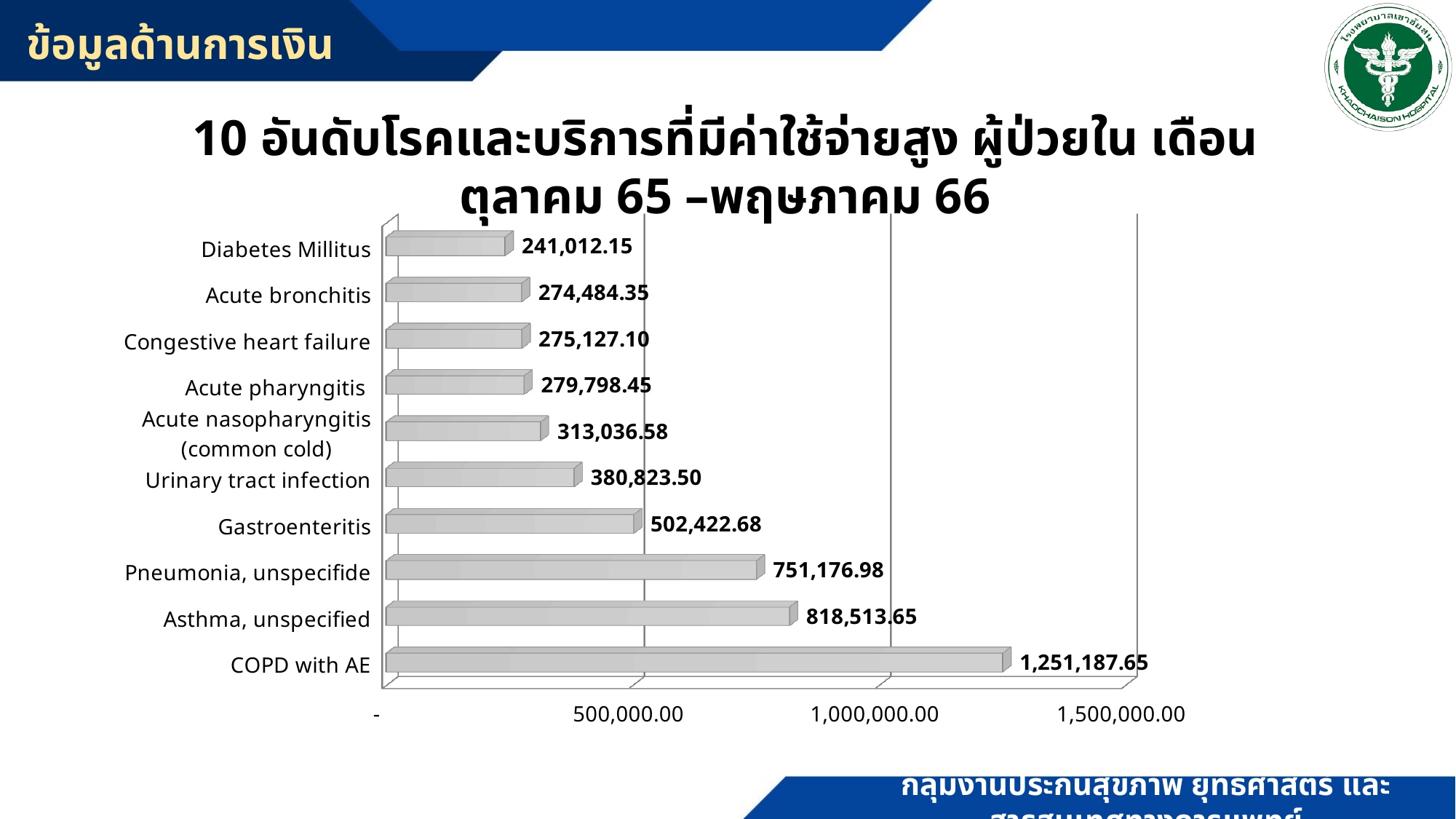
What is the value for Diabetes Millitus? 241,012.15 Is the value for Urinary tract infection greater or less than 500,000.00? less What is the value for Gastroenteritis? 502,422.68 What is the difference between the values for Gastroenteritis and Urinary tract infection? 121,599.18 Which category has the highest value? COPD with AE Which is larger, the value for Asthma, unspecified or the value for Pneumonia, unspecifide? Asthma, unspecified How many categories are shown in the chart? 10 What is the value for Acute nasopharyngitis (common cold)? 313,036.58 Which category has the lowest value? Diabetes Millitus What kind of chart is shown on the slide? bar chart What is the value for COPD with AE? 1,251,187.65 What is the difference between the values for COPD with AE and Asthma, unspecified? 432,674.00